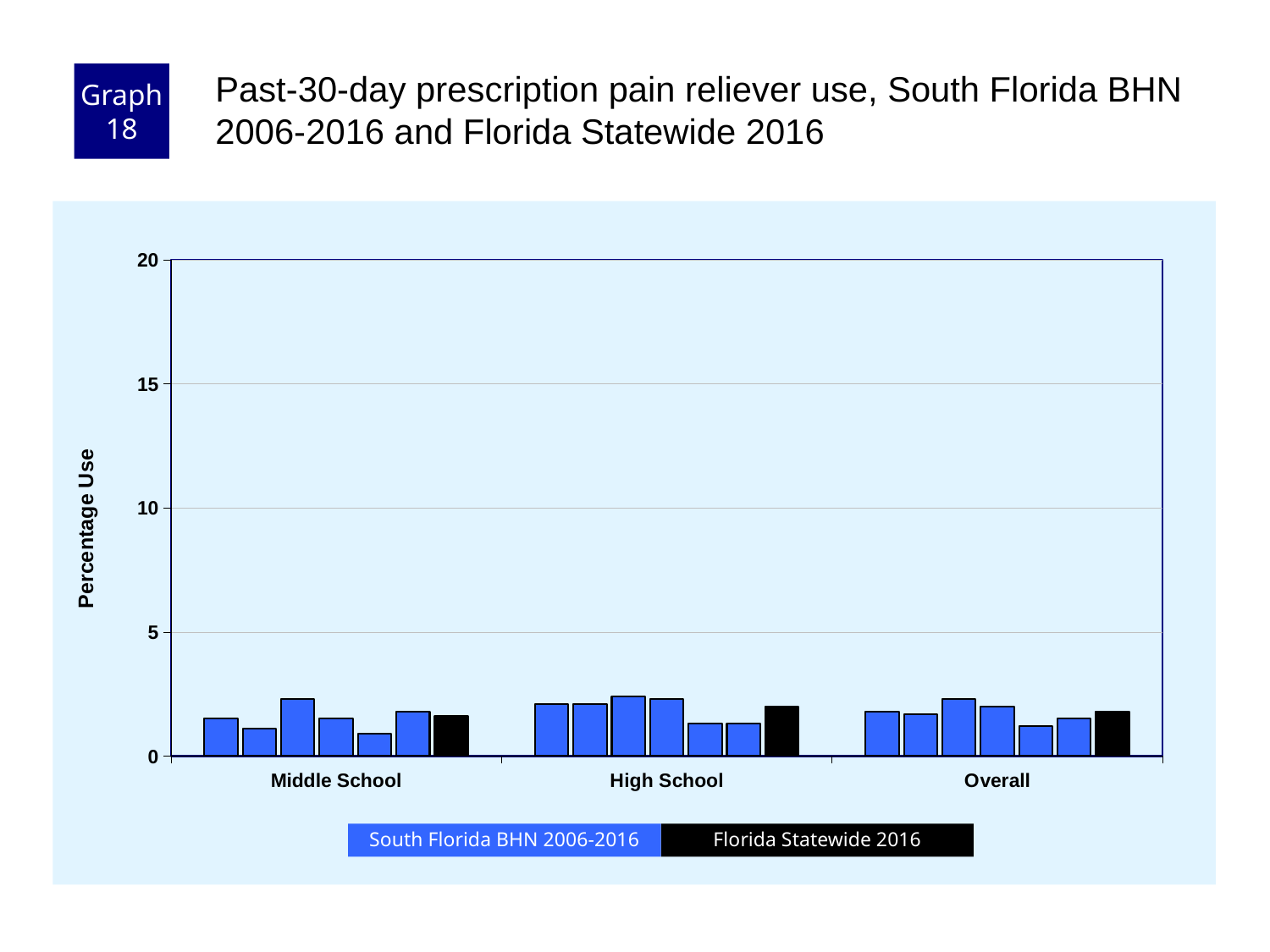
How many categories are shown along the x axis? 3 Which series is shown in black in the legend? Florida Statewide 2016 Is the Florida Statewide 2016 value for High School greater or less than 5? less What kind of chart is shown on the slide? bar chart How many series does the legend list? 2 What is the highest value shown on the y axis? 20 Are any of the South Florida BHN 2006-2016 bars for High School greater or less than 5? less Is the Florida Statewide 2016 value for Overall greater or less than 10? less What is the label on the y axis? Percentage Use